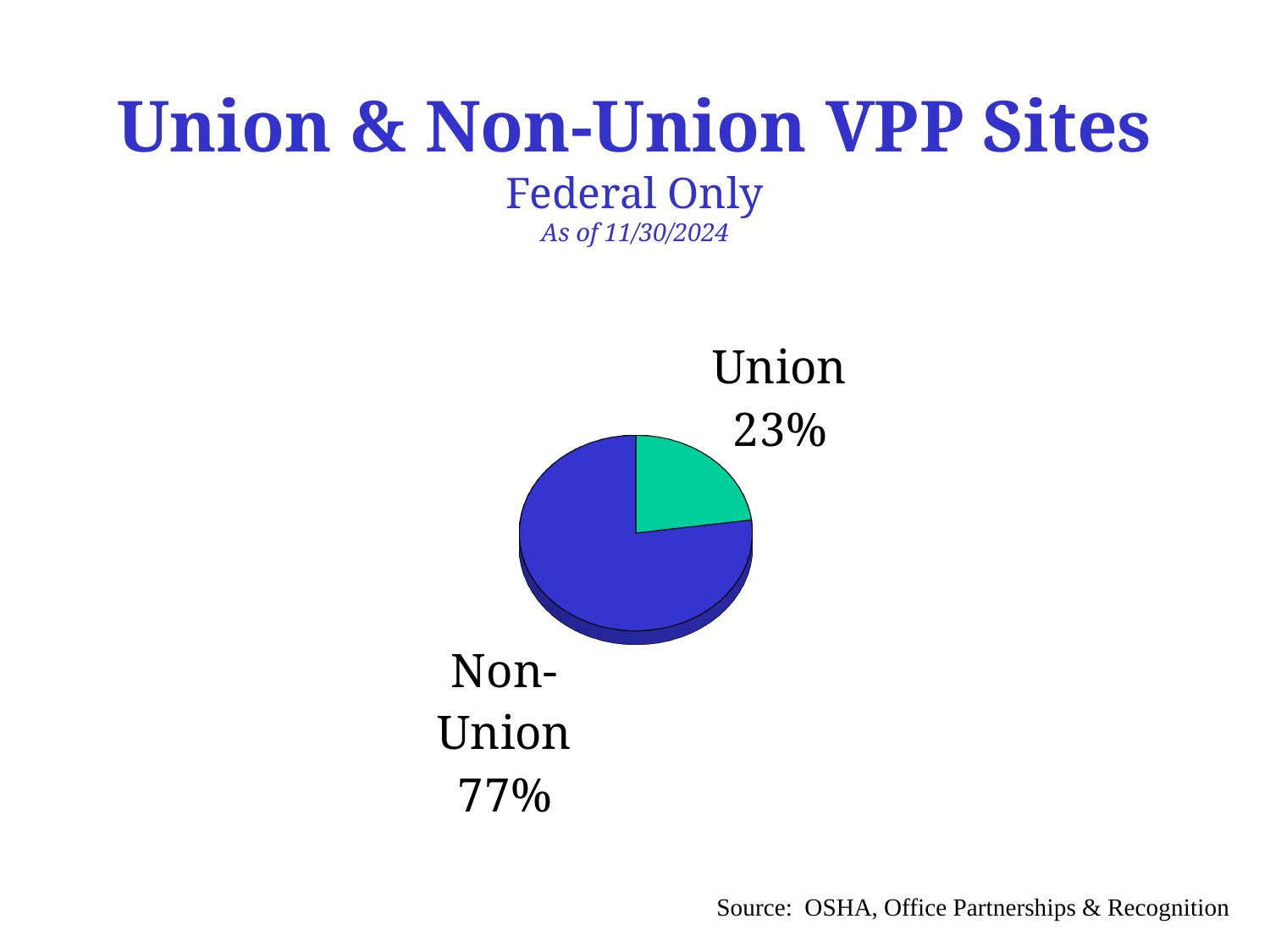
Is the Union share greater or less than 50%? less Which category has the largest slice of the pie? Non-Union What share of Federal VPP sites are Union? 23% What is the difference in percentage points between the Non-Union and Union slices? 54 How many slices does the pie chart have? 2 Which is larger, the Union slice or the Non-Union slice? Non-Union Which category has the smallest slice of the pie? Union What kind of chart is shown on the slide? Pie chart What share of Federal VPP sites are Non-Union? 77% What is the title of the chart on the slide? Union & Non-Union VPP Sites What colour is the Union slice of the pie? Green